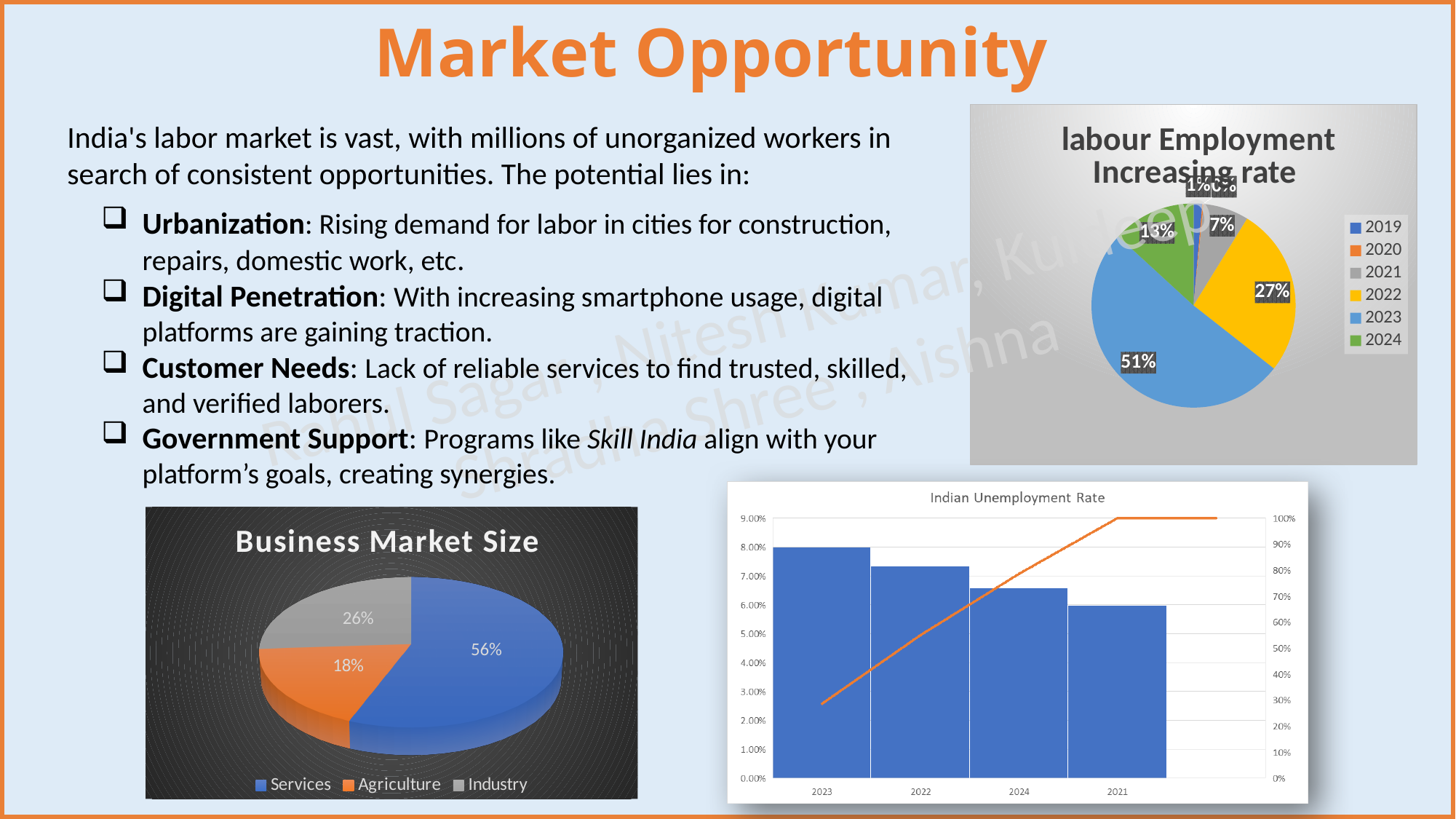
In the 'Business Market Size' chart, what share does Services have? 56% In the 'labour Employment Increasing rate' pie chart, what percentage is shown for 2023? 51% In the 'Business Market Size' chart, which is larger, Industry or Agriculture? Industry In the 'Indian Unemployment Rate' chart, which year has the tallest bar? 2023 In the 'labour Employment Increasing rate' pie chart, how many years does the legend list? 6 In the 'labour Employment Increasing rate' pie chart, what percentage is shown for 2022? 27% In the 'labour Employment Increasing rate' pie chart, what is the difference between the 2022 and 2024 percentages? 14% In the 'Business Market Size' chart, what percentage is shown for Agriculture? 18% In the 'Indian Unemployment Rate' chart, is the bar for 2021 greater or less than 7.00%? less In the 'Indian Unemployment Rate' chart, how many years are shown on the x axis? 4 In the 'labour Employment Increasing rate' pie chart, which year has the largest slice? 2023 In the 'Business Market Size' chart, which category has the smallest slice? Agriculture